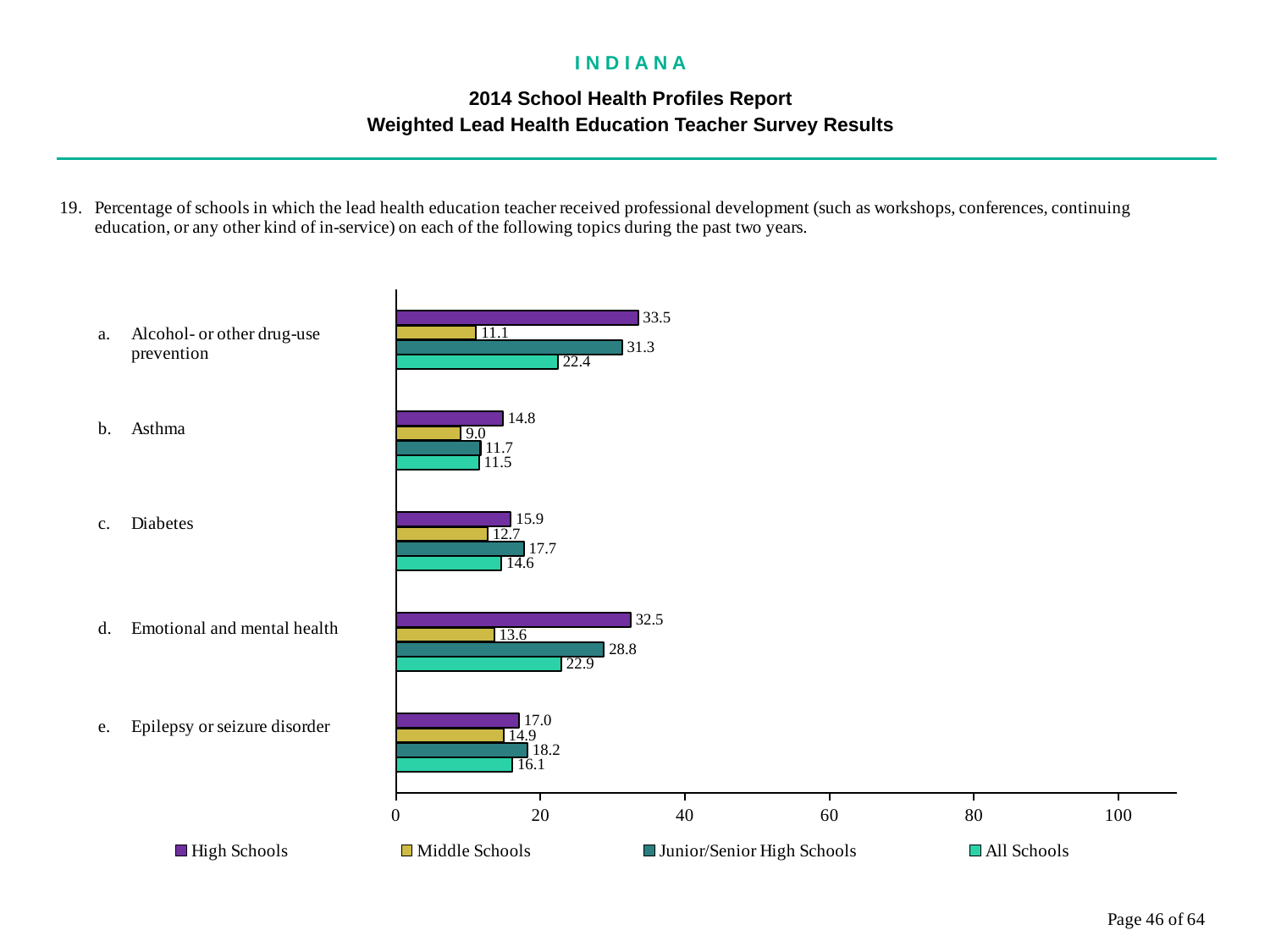
What is the difference between the High Schools and Middle Schools values for Emotional and mental health? 18.9 What is the value for Middle Schools for Asthma? 9.0 What kind of chart is shown on the slide? bar chart What is the value for High Schools for Alcohol- or other drug-use prevention? 33.5 Is the All Schools value for Alcohol- or other drug-use prevention greater or less than 20? greater How many series does the legend list? 4 What is the value for Junior/Senior High Schools for Emotional and mental health? 28.8 What is the value for All Schools for Epilepsy or seizure disorder? 16.1 How many topics are shown on the chart? 5 Which is larger for Diabetes: the High Schools value or the Junior/Senior High Schools value? Junior/Senior High Schools Which topic has the highest value for High Schools? Alcohol- or other drug-use prevention Which topic has the lowest value for Middle Schools? Asthma